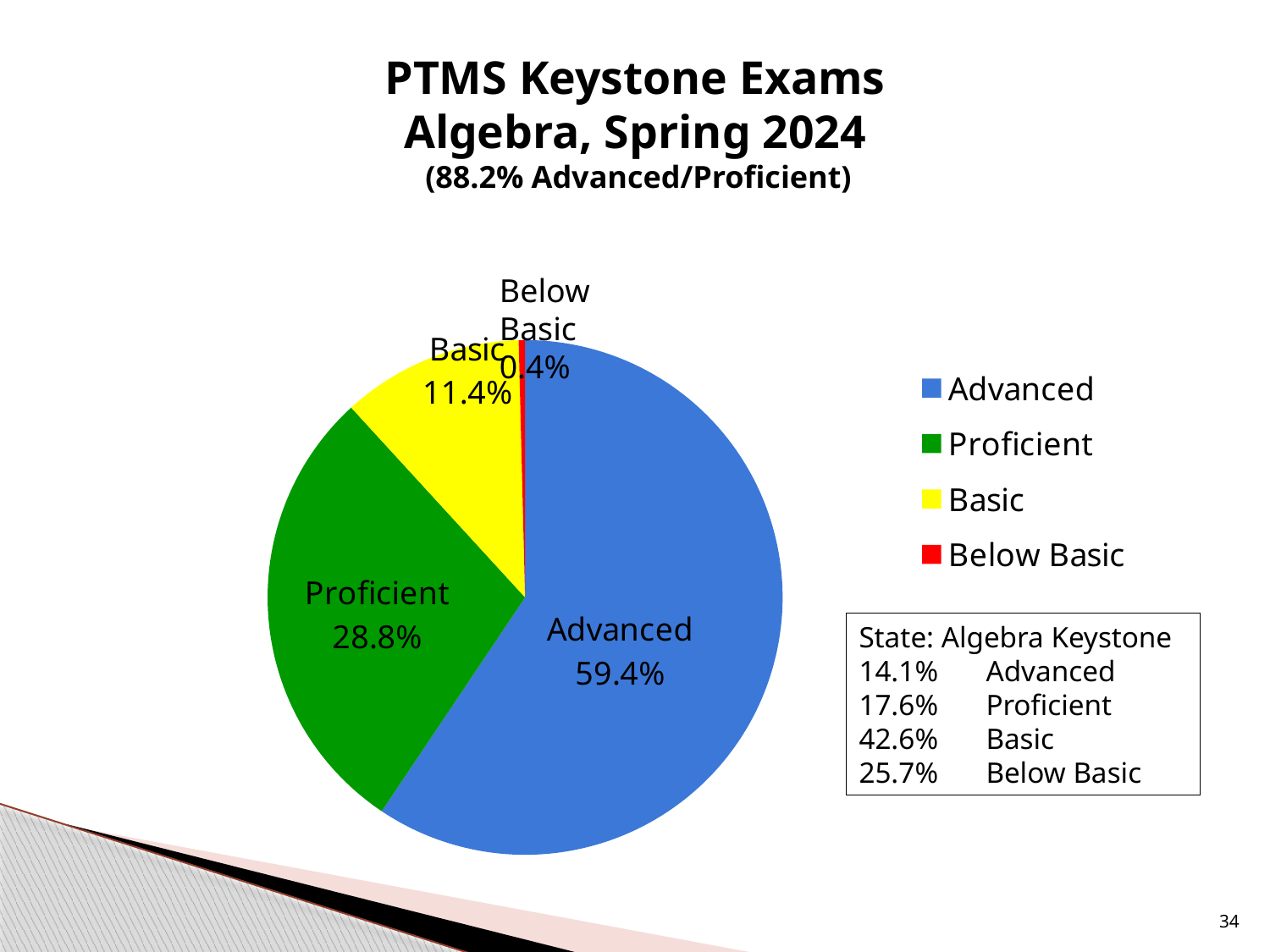
How many categories does the pie chart have? 4 What kind of chart is shown on the slide? pie chart What percentage of students scored Advanced? 59.4% What percentage of students scored Proficient? 28.8% Which category has the smallest share of the pie? Below Basic What colour represents the Basic category in the pie chart? yellow What is the combined share of Basic and Below Basic? 11.8% What is the difference between the Advanced and Proficient percentages? 30.6% What percentage of students scored Below Basic? 0.4% Which category has the largest share of the pie? Advanced Which is larger, the Basic share or the Proficient share? Proficient What percentage of students scored Basic? 11.4%